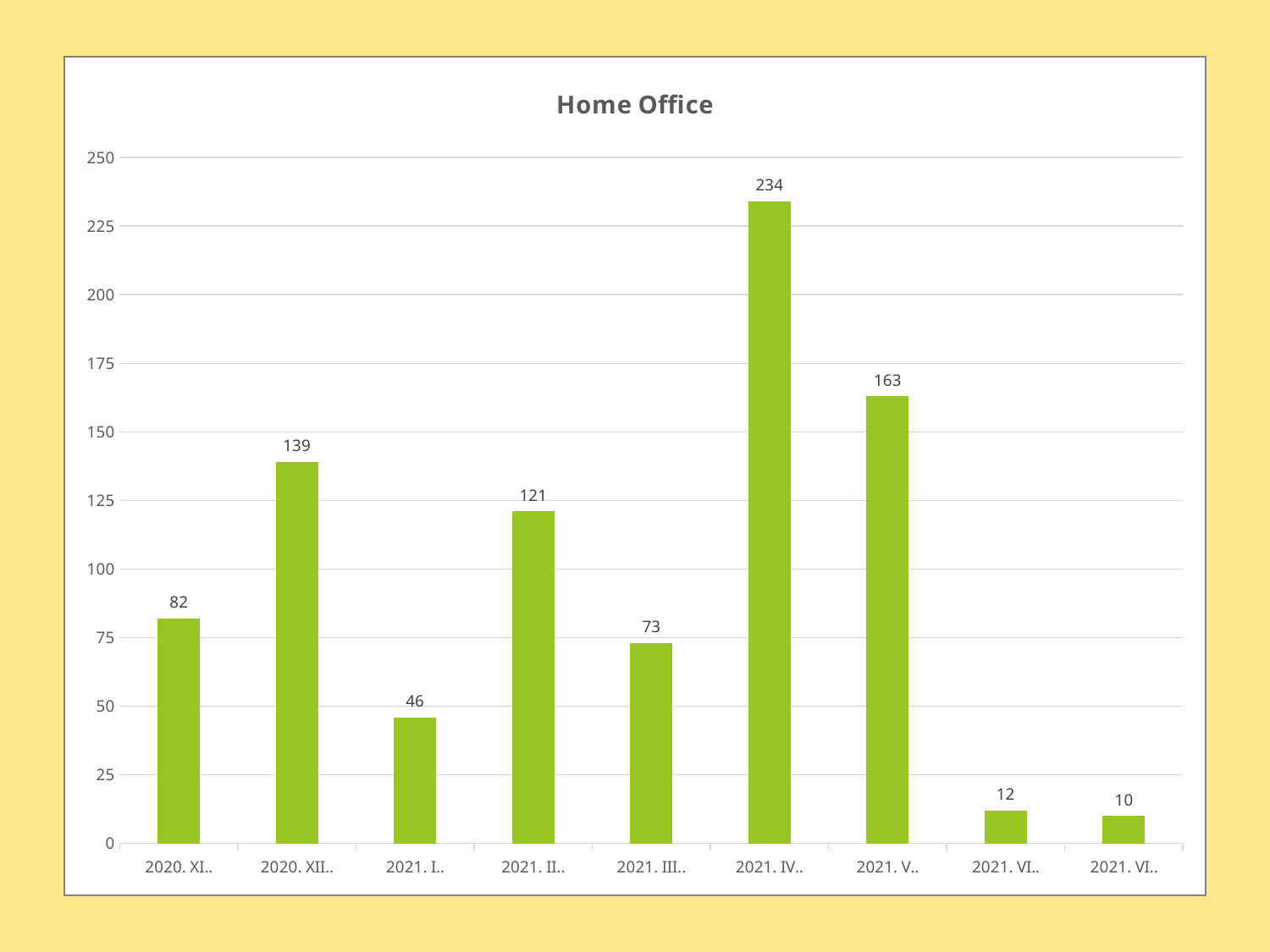
What is the value for 2020. XI..? 82 What is the value of the last (rightmost) bar? 10 What is the value for 2021. I..? 46 How many bars are plotted in the chart? 9 Which category has the highest value? 2021. IV.. What is the difference between the values for 2021. IV.. and 2021. V..? 71 Is the value for 2021. III.. greater or less than 100? less What is the difference between the values for 2020. XII.. and 2020. XI..? 57 What is the title of the chart? Home Office Which is larger, the value for 2020. XII.. or the value for 2021. II..? 2020. XII.. What kind of chart is shown on the slide? bar chart What is the value for 2021. IV..? 234